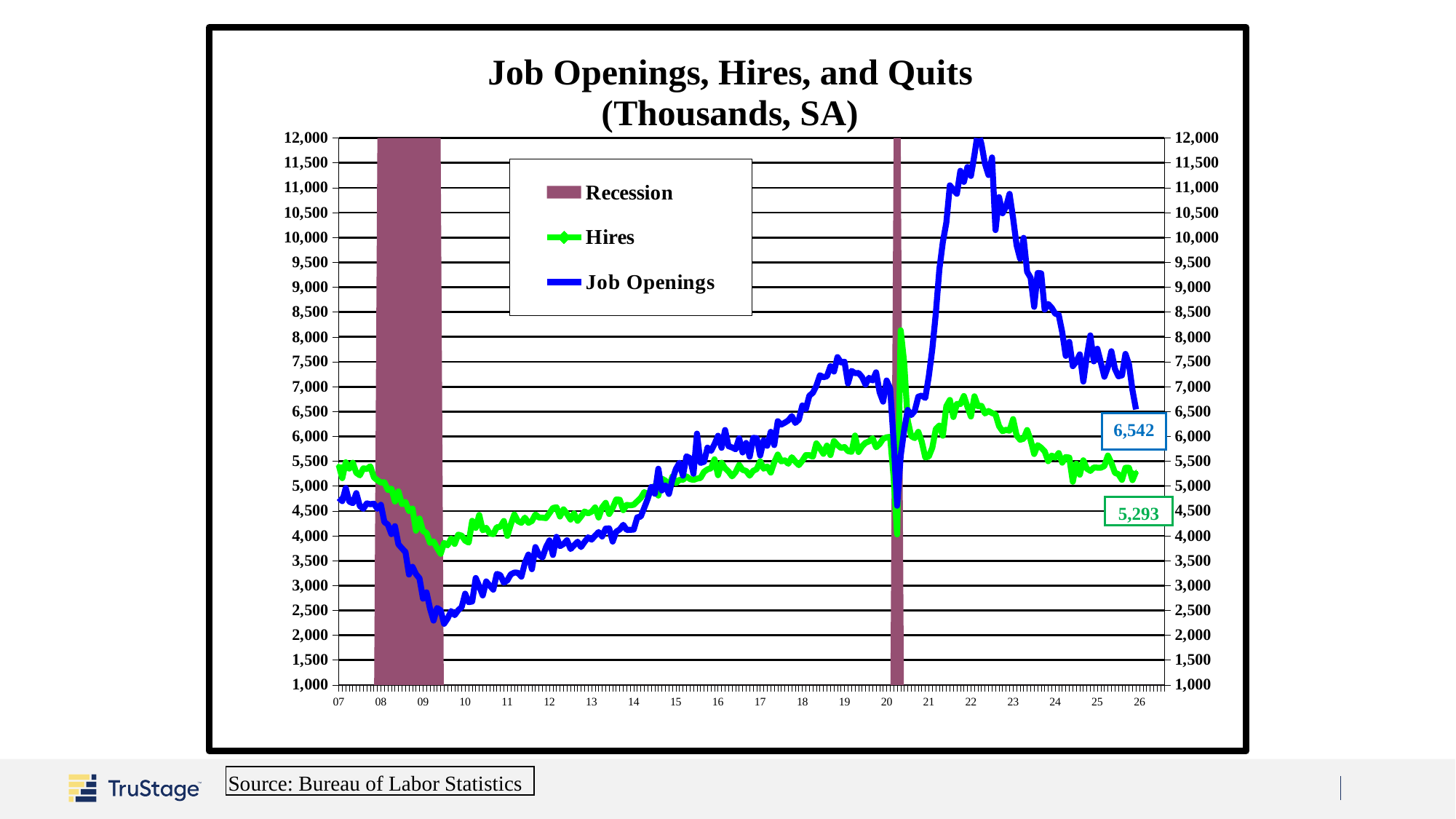
What is the title of the chart? Job Openings, Hires, and Quits (Thousands, SA) What is the latest labeled value for Hires? 5,293 Which colour is used for the Hires line? green At the end of the series, which is larger: Job Openings or Hires? Job Openings What is the difference between the latest labeled Job Openings value and the latest labeled Hires value? 1,249 What kind of chart is shown on the slide? line chart Do Job Openings rise or fall from 2022 to 2026? fall What is the latest labeled value for Job Openings? 6,542 Is the peak value of Job Openings around 2022 greater or less than 11,000? greater Is the lowest value of Job Openings around 2009 greater or less than 2,500? less Is the lowest value of Hires around 2009 greater or less than 4,000? less How many entries does the legend list? 3